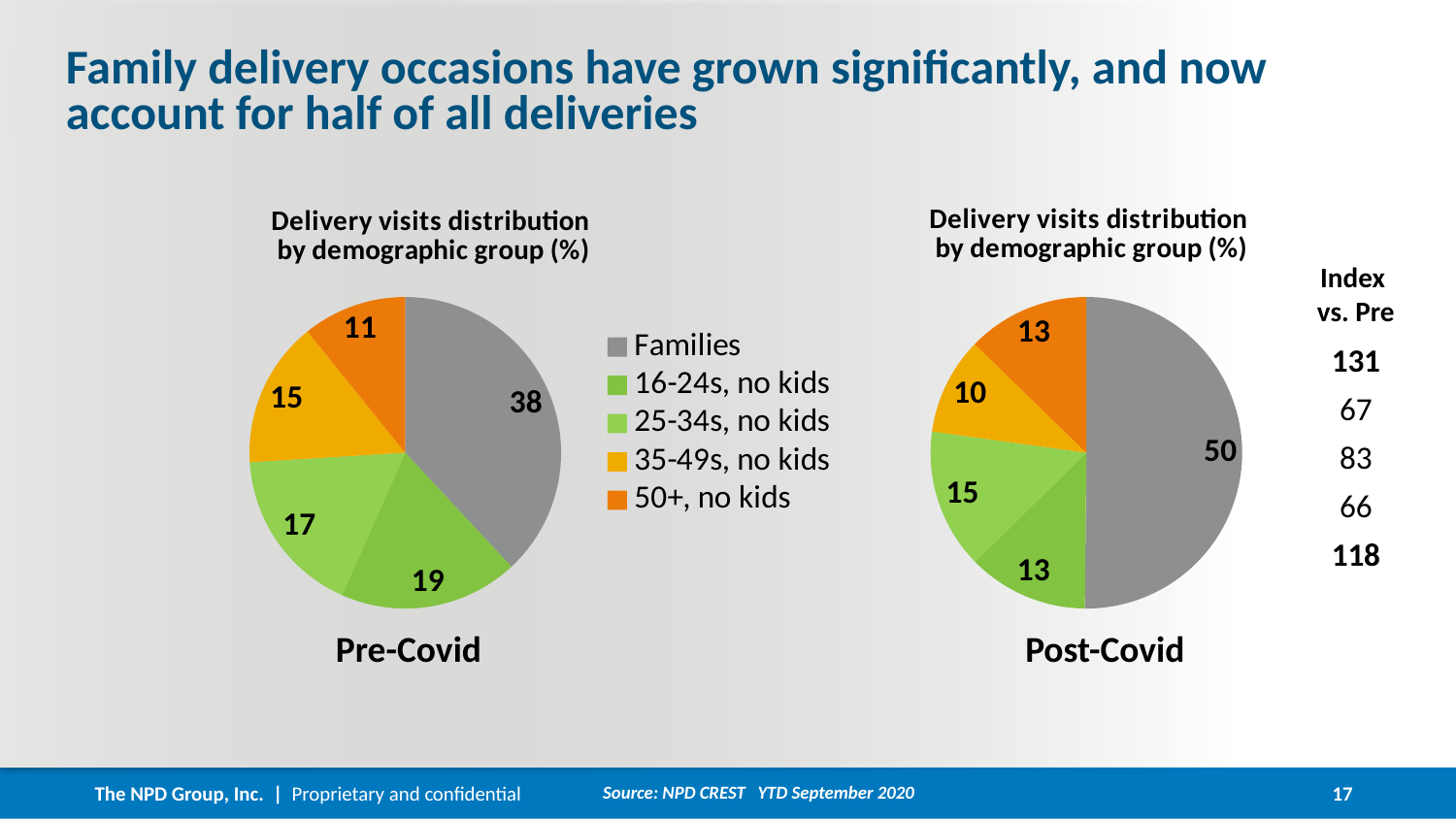
In the Post-Covid pie chart, what share of delivery visits do Families account for? 50 In the Pre-Covid pie chart, which is larger: the share for 25-34s, no kids or the share for 35-49s, no kids? 25-34s, no kids How much larger is the Families share in the Post-Covid pie chart than in the Pre-Covid pie chart? 12 In the Pre-Covid pie chart, what is the value for 16-24s, no kids? 19 What colour represents Families in the pie charts? Gray In the Pre-Covid pie chart, what share of delivery visits do Families account for? 38 What type of chart is used for the Pre-Covid and Post-Covid distributions? Pie chart In the Pre-Covid pie chart, which demographic group has the smallest share? 50+, no kids In the Post-Covid pie chart, what is the value for 35-49s, no kids? 10 In the Pre-Covid pie chart, what is the combined share of 16-24s, no kids and 25-34s, no kids? 36 In the Post-Covid pie chart, which demographic group has the largest share? Families How many demographic groups does the legend list? 5